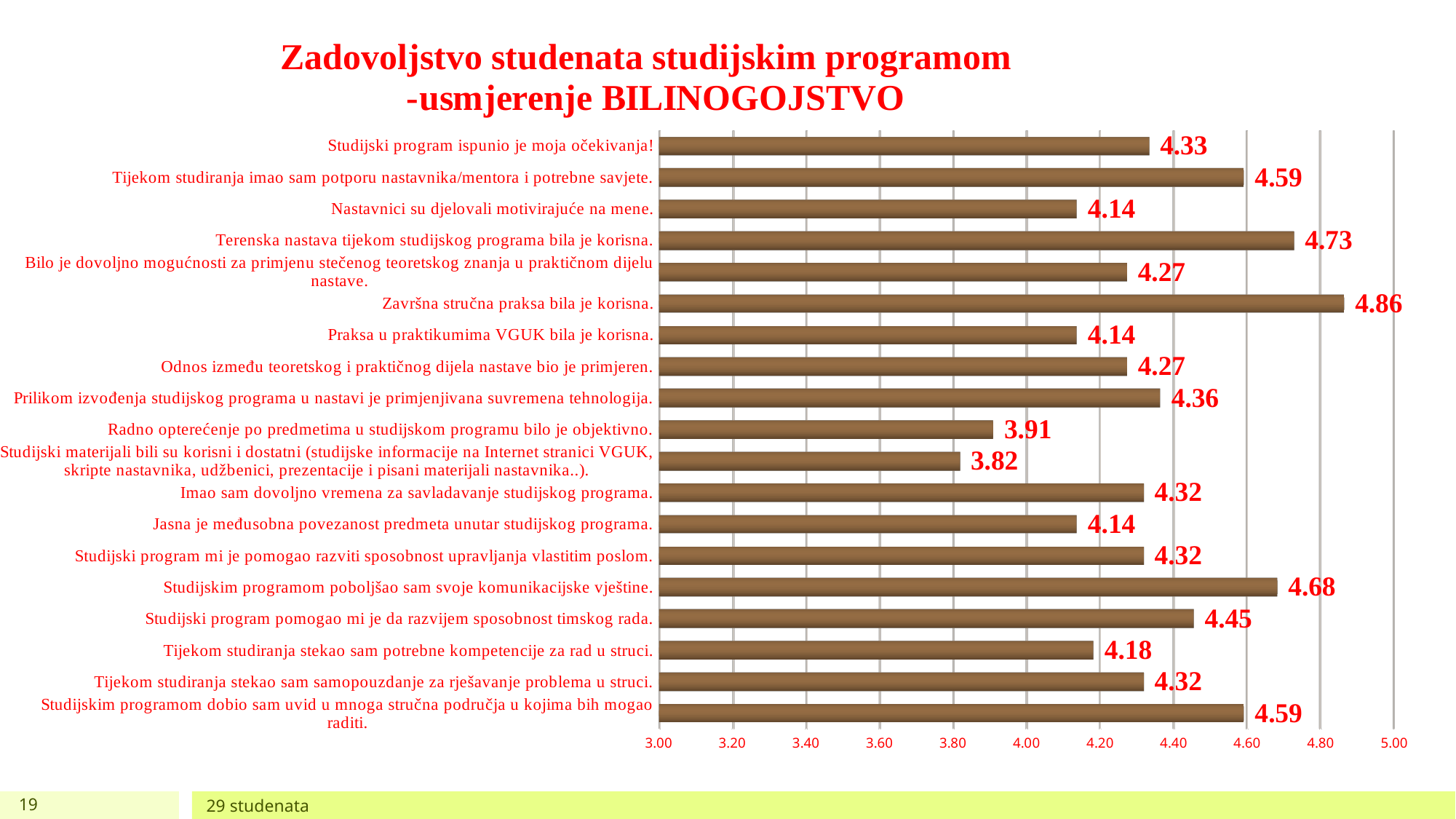
What is the difference between the values for "Završna stručna praksa bila je korisna." and "Nastavnici su djelovali motivirajuće na mene."? 0.72 How many statements (bars) are shown on the chart? 19 What is the title of the chart? Zadovoljstvo studenata studijskim programom -usmjerenje BILINOGOJSTVO What kind of chart is shown on the slide? bar chart What is the value for "Studijski program ispunio je moja očekivanja!"? 4.33 Which is larger: the value for "Studijskim programom poboljšao sam svoje komunikacijske vještine." or for "Studijski program pomogao mi je da razvijem sposobnost timskog rada."? Studijskim programom poboljšao sam svoje komunikacijske vještine. Which statement has the highest value? Završna stručna praksa bila je korisna. What is the value for "Radno opterećenje po predmetima u studijskom programu bilo je objektivno."? 3.91 Is the value for "Tijekom studiranja stekao sam potrebne kompetencije za rad u struci." greater or less than 4.00? greater What is the value for "Terenska nastava tijekom studijskog programa bila je korisna."? 4.73 What is the value for "Završna stručna praksa bila je korisna."? 4.86 What is the lowest value shown on the chart? 3.82